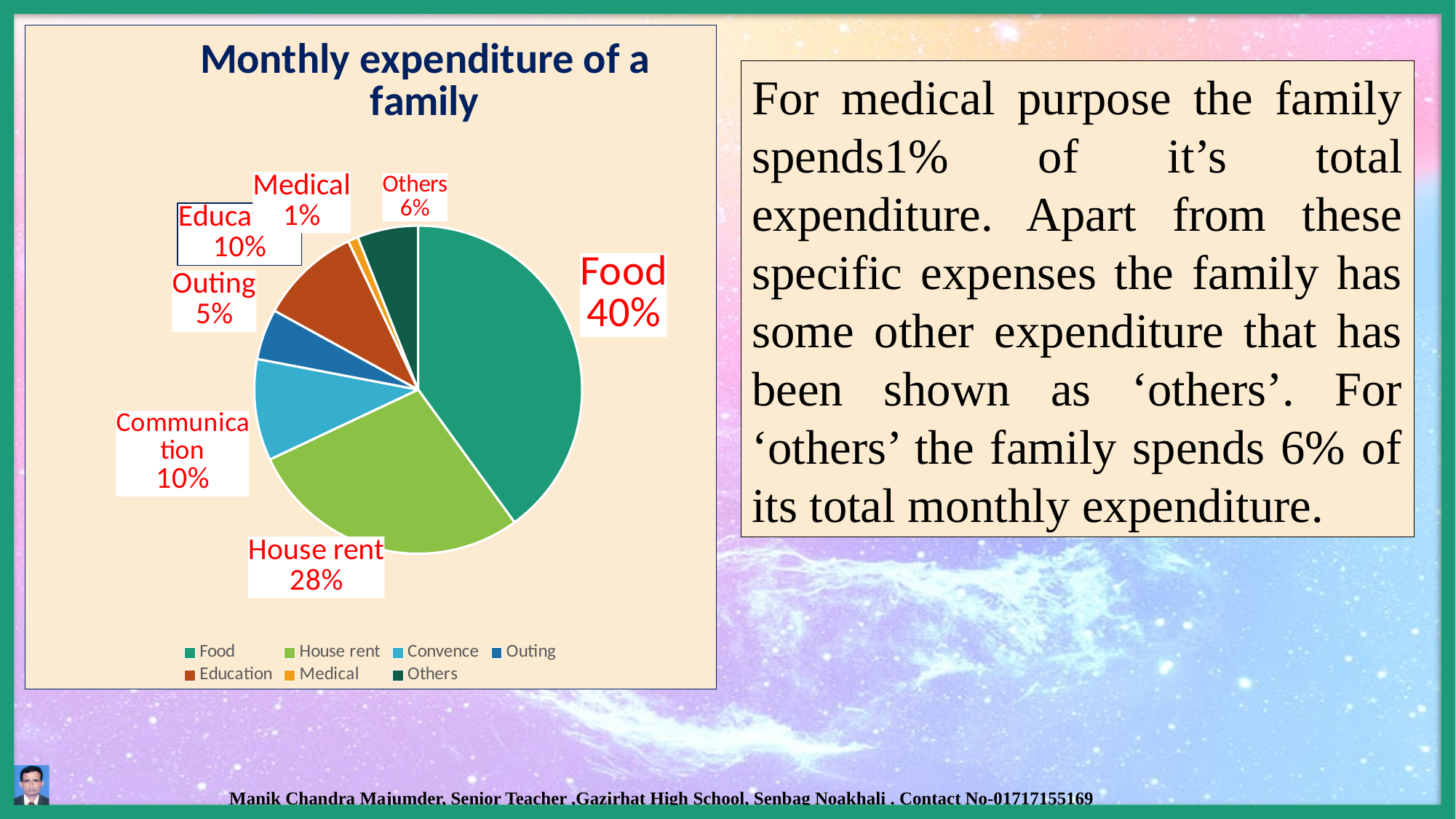
What percentage is labelled for Others? 6% What share of the monthly expenditure is House rent? 28% How many slices does the pie chart have? 7 Which category has the smallest share of the monthly expenditure? Medical What percentage is labelled for Outing? 5% What percentage is labelled for Medical? 1% What percentage of the monthly expenditure goes to Food? 40% Which is larger, the share for Others or the share for Outing? Others What type of chart is shown on the slide? Pie chart Which category has the largest share of the monthly expenditure? Food What is the difference in percentage points between Food and House rent? 12 What is the title of the chart? Monthly expenditure of a family